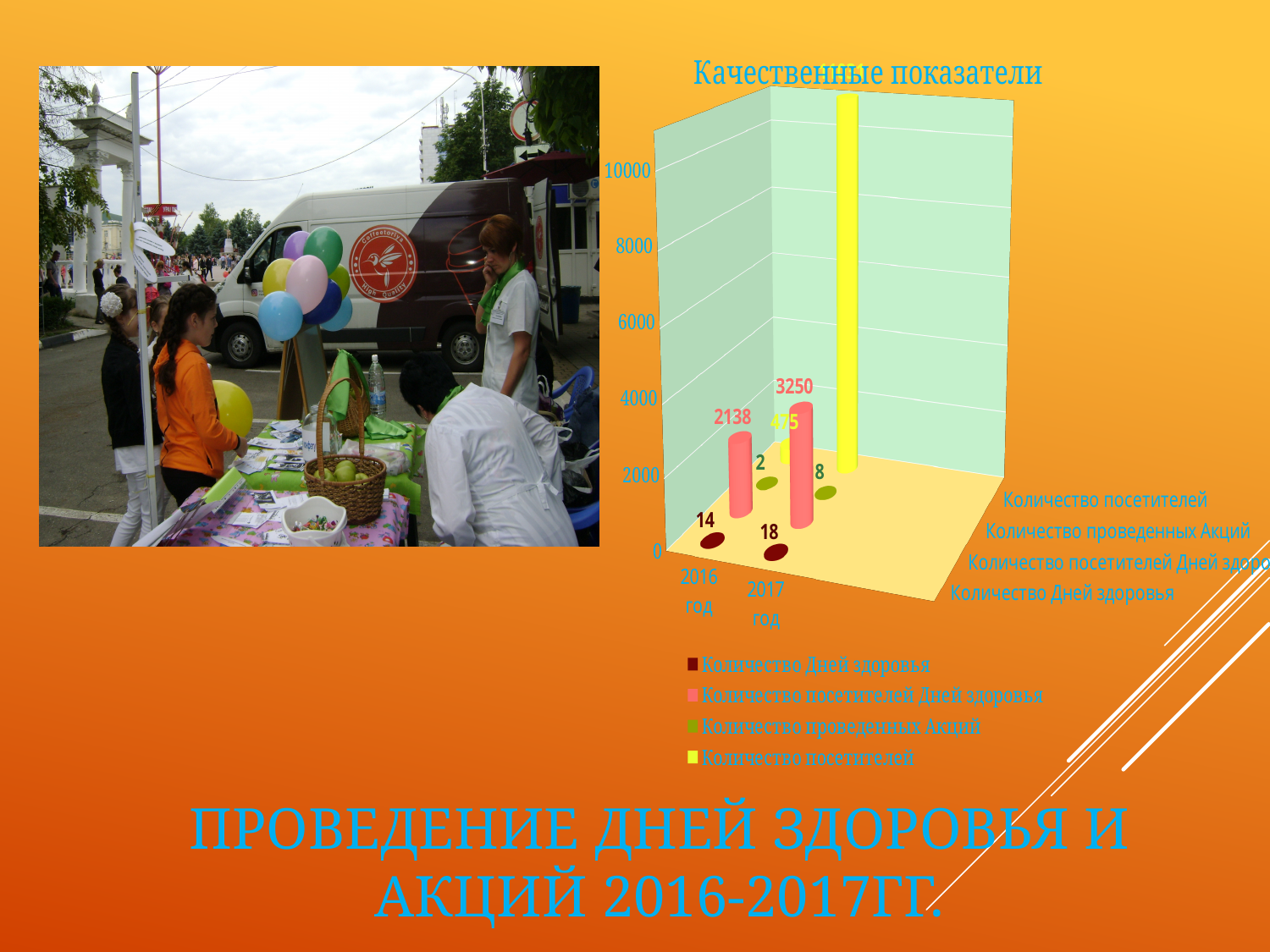
What is the value of "Количество Дней здоровья" for 2016 год? 14 How many year categories are shown on the chart's x axis? 2 Is the value of "Количество посетителей" for 2017 год greater or less than 10000? greater What kind of chart is shown under the title "Качественные показатели"? bar chart By how much did "Количество посетителей Дней здоровья" increase from 2016 год to 2017 год? 1112 What is the value of "Количество проведенных Акций" for 2017 год? 8 Does "Количество посетителей Дней здоровья" rise or fall from 2016 год to 2017 год? rise What is the value of "Количество посетителей Дней здоровья" for 2016 год? 2138 What is the title of the chart on the slide? Качественные показатели How many series does the chart legend list? 4 What is the value of "Количество посетителей Дней здоровья" for 2017 год? 3250 What is the value of "Количество Дней здоровья" for 2017 год? 18